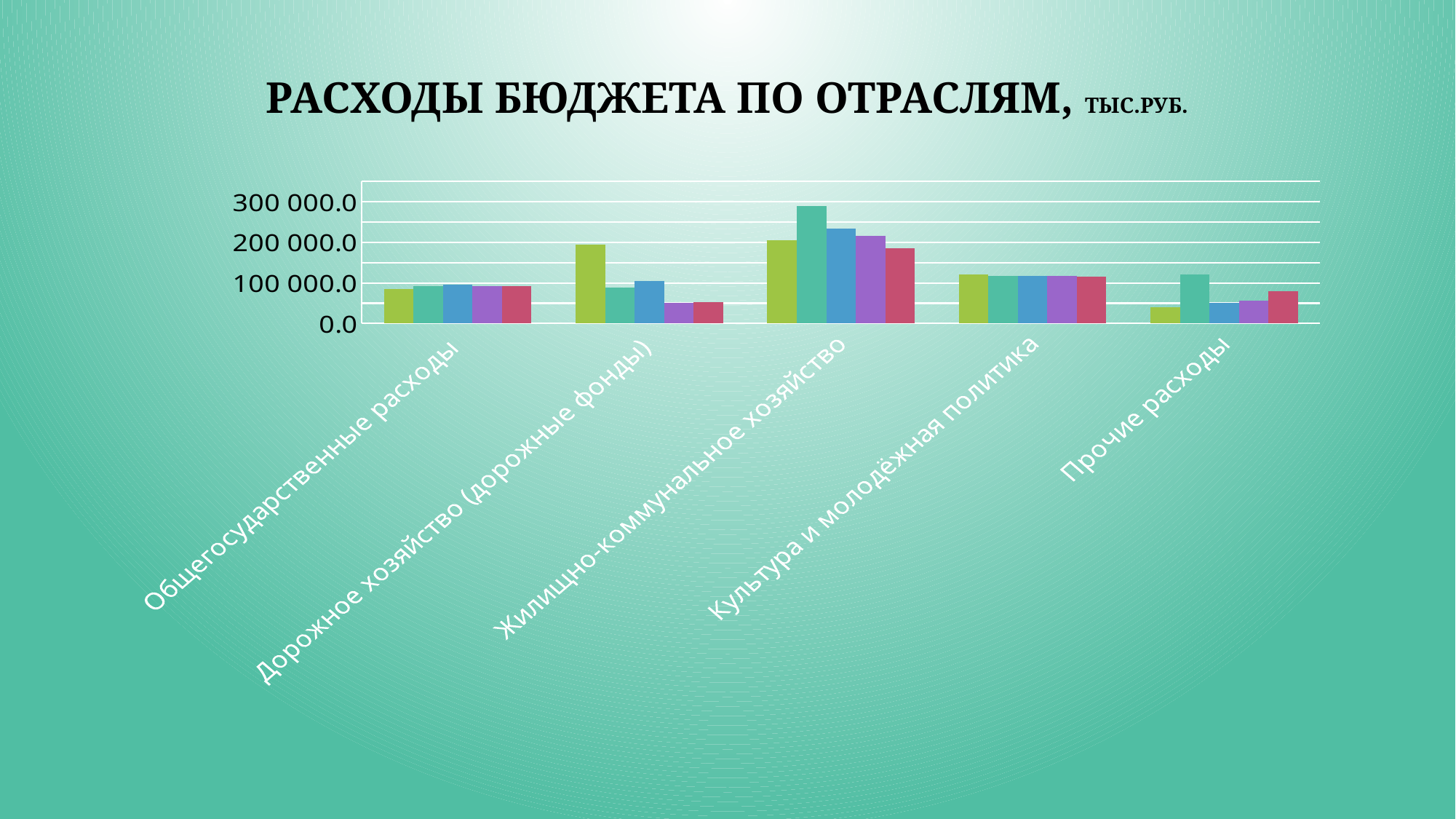
What is the title of the chart on the slide? РАСХОДЫ БЮДЖЕТА ПО ОТРАСЛЯМ, тыс.руб. How many bars are plotted for each category in the chart? 5 Which category contains the shortest bar in the chart? Прочие расходы Is the value of the purple (fourth) bar for Жилищно-коммунальное хозяйство greater or less than 200 000.0? greater Is the value of the green (first) bar for Прочие расходы greater or less than 100 000.0? less Which is larger: the green (first) bar for Дорожное хозяйство (дорожные фонды) or the green (first) bar for Общегосударственные расходы? Дорожное хозяйство (дорожные фонды) Is the value of the red (last) bar for Дорожное хозяйство (дорожные фонды) greater or less than 100 000.0? less Which category contains the tallest bar in the chart? Жилищно-коммунальное хозяйство Which is larger: the teal (second) bar for Жилищно-коммунальное хозяйство or the teal (second) bar for Прочие расходы? Жилищно-коммунальное хозяйство How many categories are shown on the x axis of the chart? 5 What kind of chart is shown on the slide? Bar chart